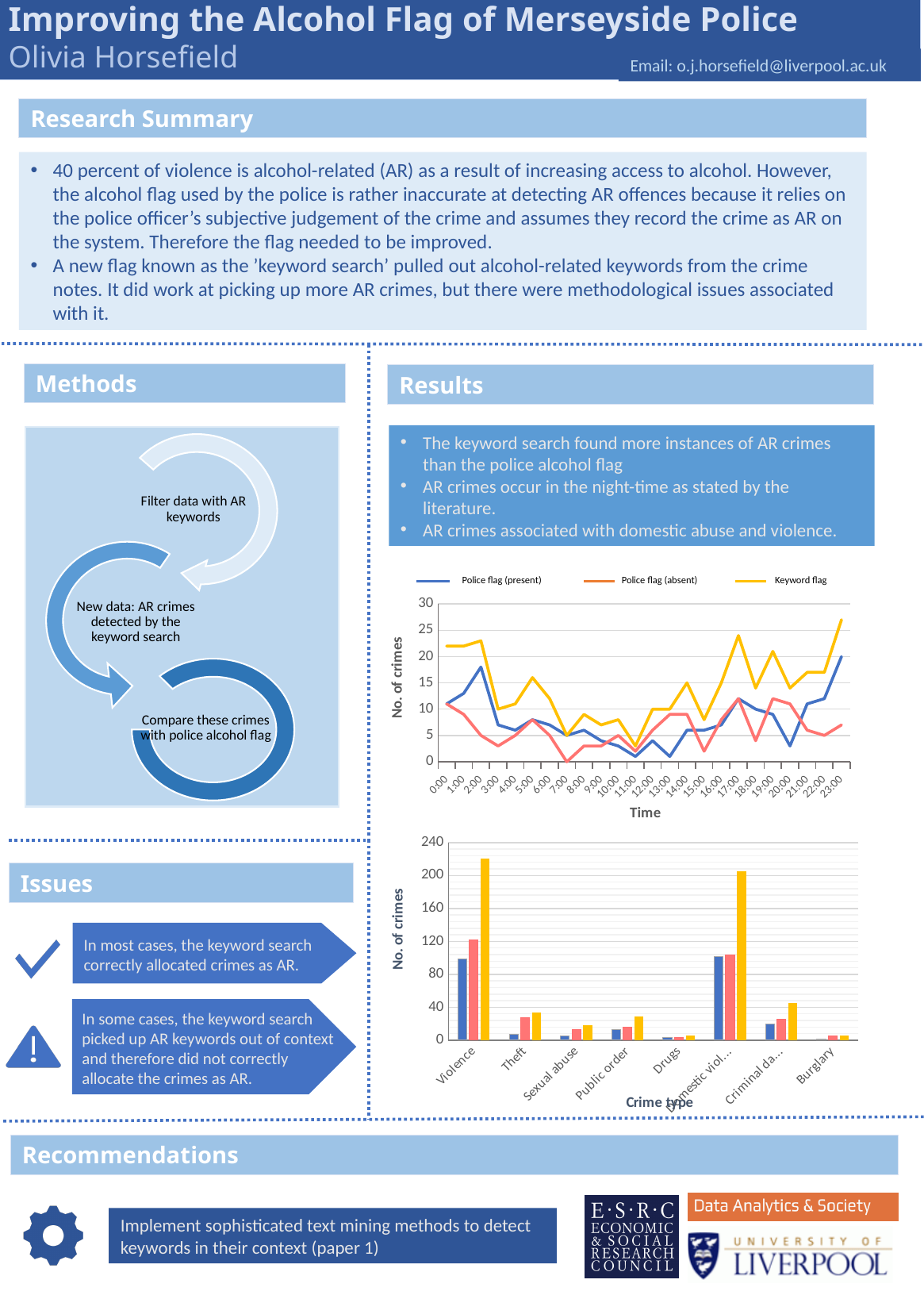
In the upper chart (Time), at 17:00, which is larger: the Keyword flag value or the Police flag (present) value? Keyword flag What is the y-axis title of the lower chart (Crime type)? No. of crimes In the lower chart (Crime type), how many crime type categories are shown on the x axis? 8 In the lower chart (Crime type), which crime type has the tallest bar? Violence In the upper chart (Time), does the Police flag (present) line rise or fall from 20:00 to 23:00? rise What kind of chart is the upper chart in the Results section (the one with Time on the x axis)? line chart In the upper chart (Time), how many time points are shown along the x axis? 24 In the upper chart (Time), is the Police flag (absent) value at 7:00 greater or less than 5? less In the upper chart (Time), is the Keyword flag value at 23:00 greater or less than 25? greater What kind of chart is the lower chart in the Results section (the one with Crime type on the x axis)? bar chart In the upper chart (Time), how many series does the legend list? 3 In the lower chart (Crime type), is the tallest bar for Violence greater or less than 200? greater